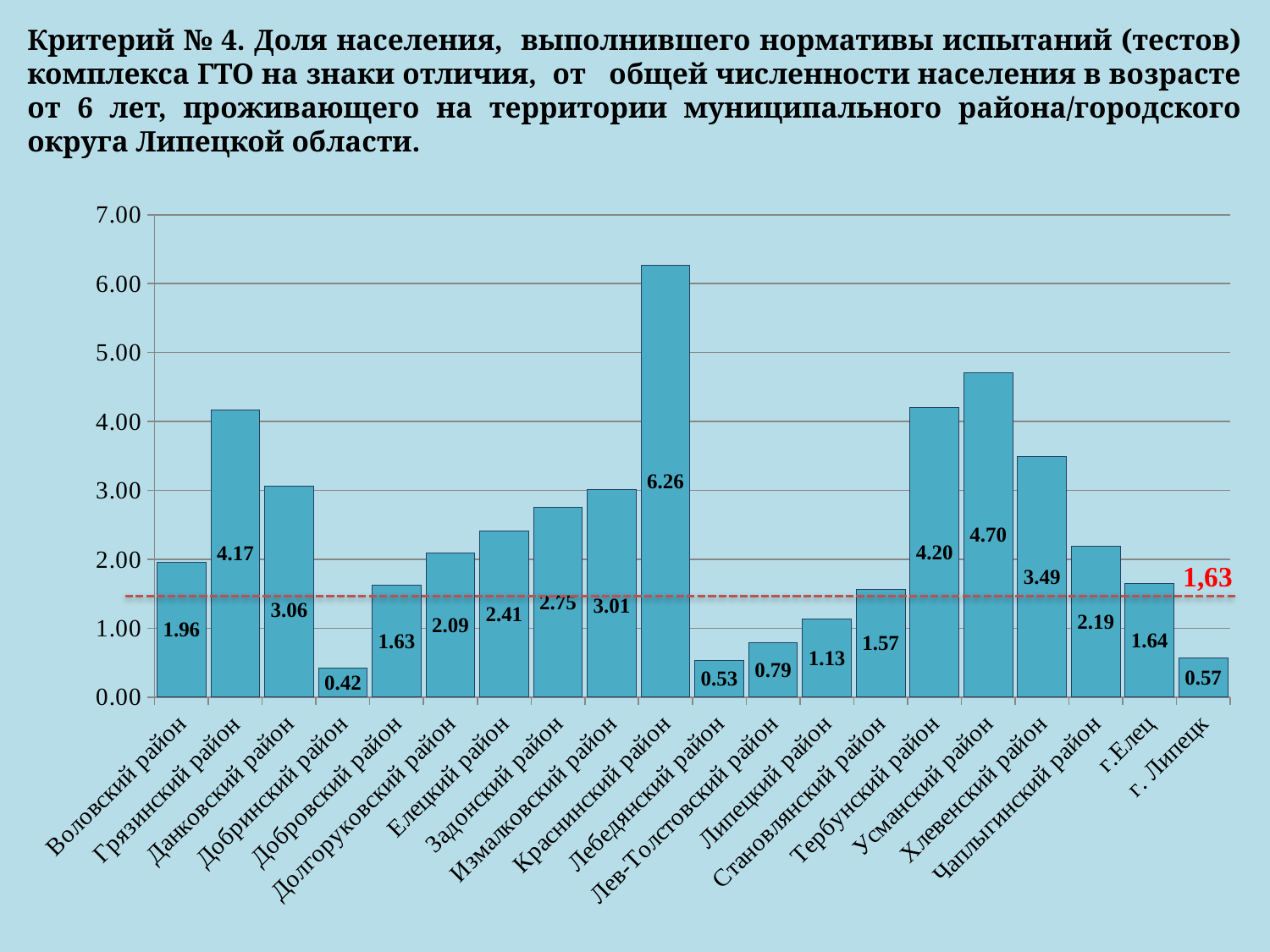
What is the difference between the values for Грязинский район and Данковский район? 1.11 What is the value for Усманский район? 4.70 What is the value for г. Липецк? 0.57 What is the value for Краснинский район? 6.26 Which is larger, the value for Хлевенский район or the value for Чаплыгинский район? Хлевенский район What is the value for Добровский район? 1.63 Which category has the lowest value? Добринский район What is the difference between the values for Усманский район and Тербунский район? 0.50 How many categories are shown on the x axis? 20 What value is marked by the red dashed horizontal line? 1,63 Is the value for Задонский район greater or less than 2.00? greater Which category has the highest value? Краснинский район